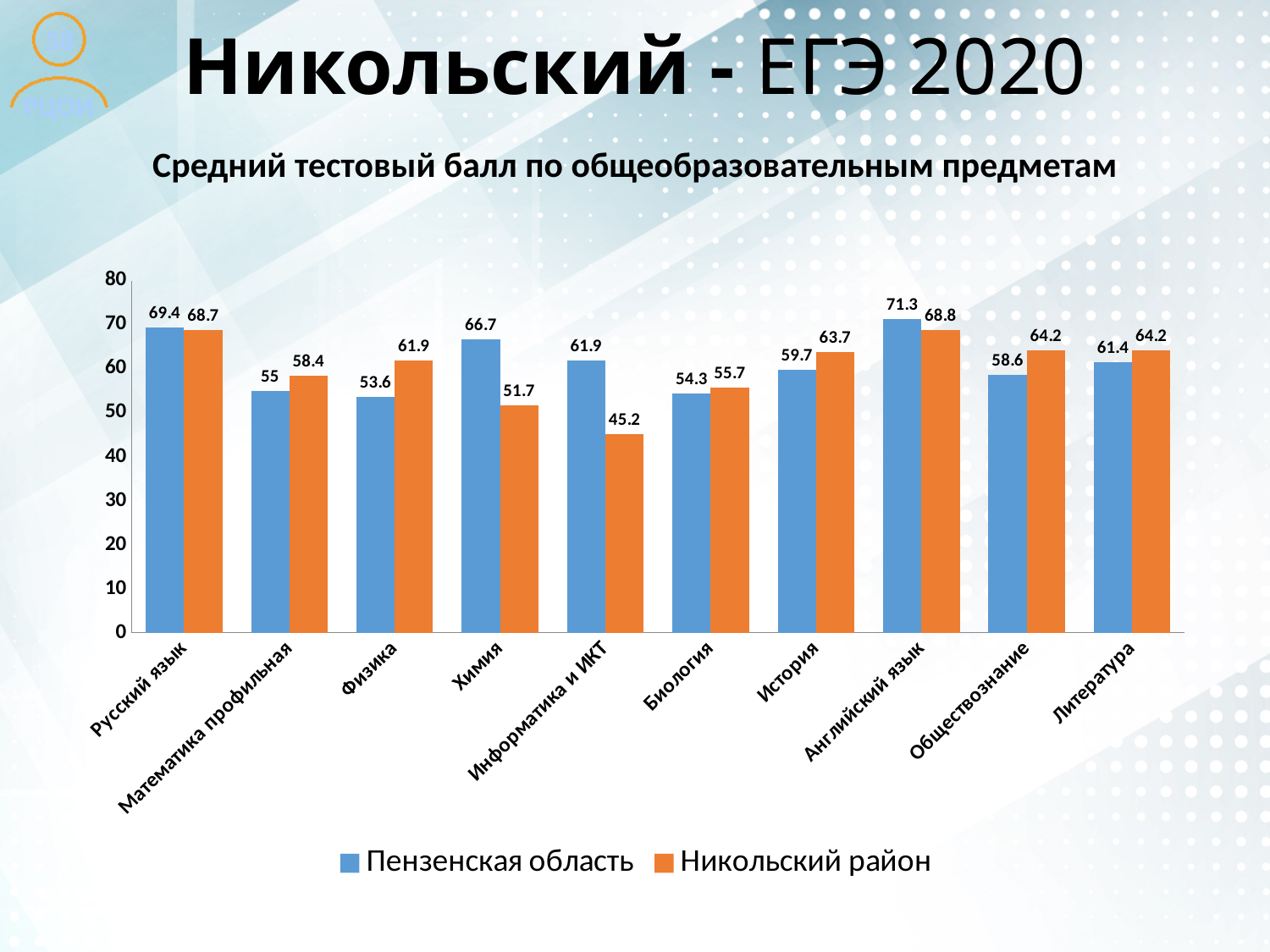
What kind of chart is shown on the slide? bar chart How many subjects are shown on the x axis? 10 What is the value for Никольский район in Обществознание? 64.2 What is the value for Пензенская область in Русский язык? 69.4 How many series does the legend list? 2 What is the subtitle of the chart? Средний тестовый балл по общеобразовательным предметам Is the value for Никольский район in Информатика и ИКТ greater or less than 50? less What is the value for Никольский район in Информатика и ИКТ? 45.2 What is the difference between Пензенская область and Никольский район in Химия? 15 Which subject has the lowest value for Никольский район? Информатика и ИКТ Which is larger in Физика: Пензенская область or Никольский район? Никольский район Which subject has the highest value for Пензенская область? Английский язык